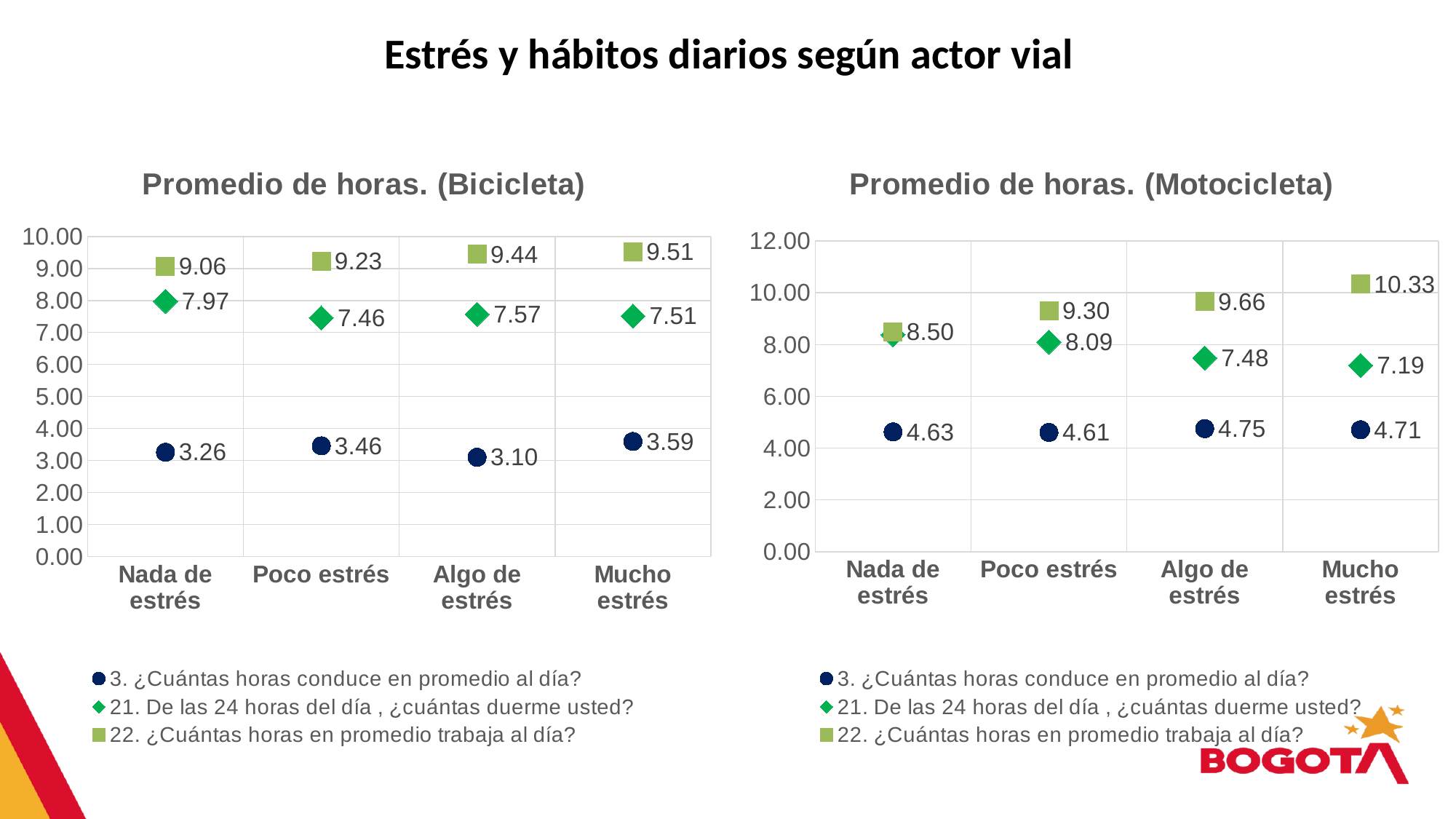
How many series does the legend of the 'Promedio de horas. (Motocicleta)' chart list? 3 In the 'Promedio de horas. (Motocicleta)' chart, which category has the highest value for '3. ¿Cuántas horas conduce en promedio al día?'? Algo de estrés In the 'Promedio de horas. (Motocicleta)' chart, which is larger: the '21. De las 24 horas del día , ¿cuántas duerme usted?' value at 'Algo de estrés' or at 'Mucho estrés'? Algo de estrés In the 'Promedio de horas. (Bicicleta)' chart, which category has the highest value for '21. De las 24 horas del día , ¿cuántas duerme usted?'? Nada de estrés In the 'Promedio de horas. (Bicicleta)' chart, what is the difference between the '22. ¿Cuántas horas en promedio trabaja al día?' values at 'Mucho estrés' and 'Nada de estrés'? 0.45 In the 'Promedio de horas. (Motocicleta)' chart, what is the value for '21. De las 24 horas del día , ¿cuántas duerme usted?' at 'Poco estrés'? 8.09 In the 'Promedio de horas. (Bicicleta)' chart, what is the value for '3. ¿Cuántas horas conduce en promedio al día?' at 'Algo de estrés'? 3.10 How many categories are shown on the x axis of the 'Promedio de horas. (Bicicleta)' chart? 4 In the 'Promedio de horas. (Bicicleta)' chart, which category has the lowest value for '3. ¿Cuántas horas conduce en promedio al día?'? Algo de estrés In the 'Promedio de horas. (Motocicleta)' chart, what is the value for '22. ¿Cuántas horas en promedio trabaja al día?' at 'Mucho estrés'? 10.33 In the 'Promedio de horas. (Bicicleta)' chart, do the values for '22. ¿Cuántas horas en promedio trabaja al día?' rise or fall from 'Nada de estrés' to 'Mucho estrés'? rise In the 'Promedio de horas. (Bicicleta)' chart, what is the value for '22. ¿Cuántas horas en promedio trabaja al día?' at 'Mucho estrés'? 9.51